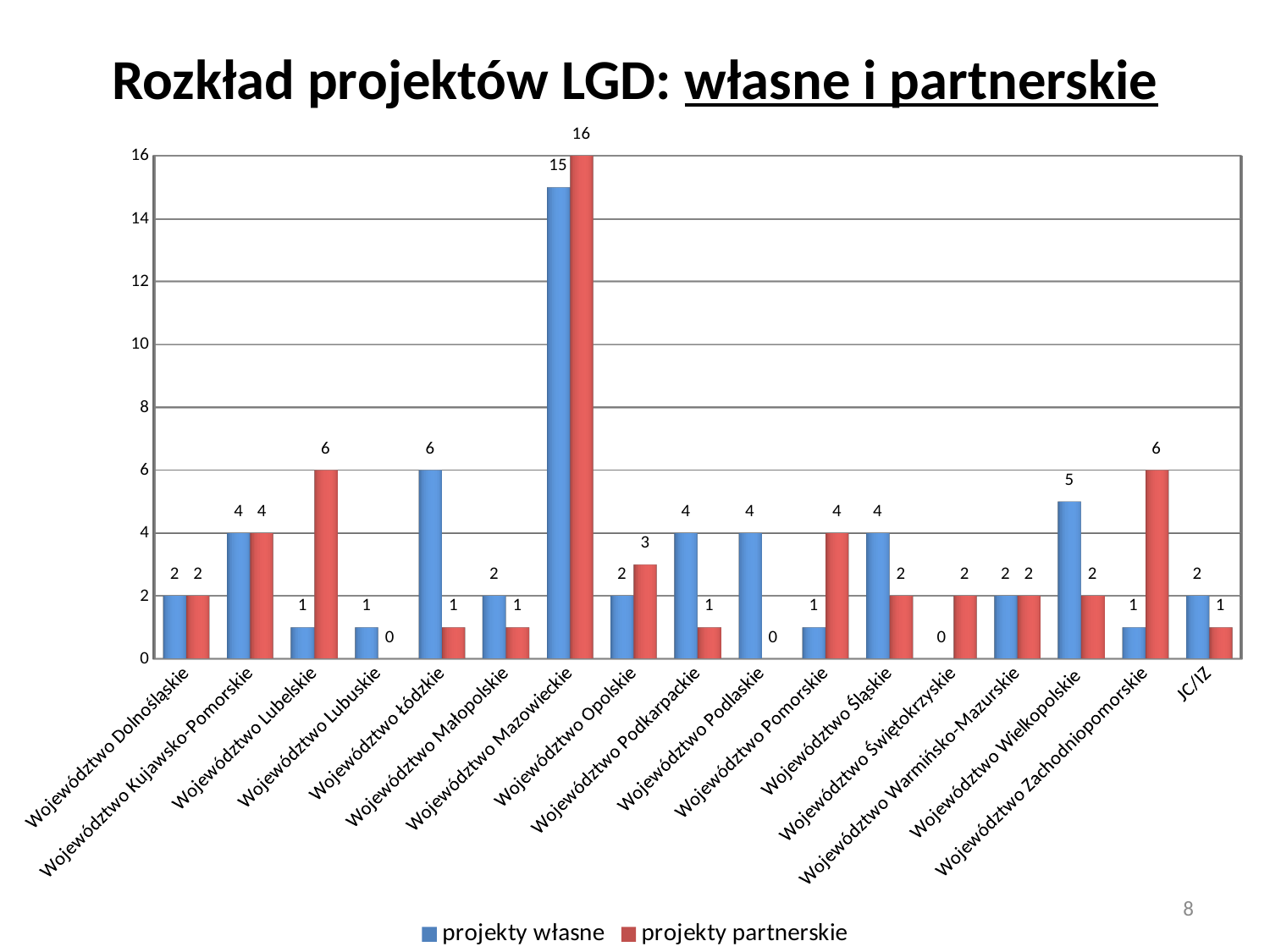
What kind of chart is shown on the slide? bar chart Which colour represents projekty partnerskie in the legend? red Is the value of projekty własne for Województwo Mazowieckie greater or less than 10? greater What is the value of projekty partnerskie for Województwo Zachodniopomorskie? 6 What is the value of projekty własne for Województwo Mazowieckie? 15 What is the value of projekty partnerskie for Województwo Podlaskie? 0 How many series does the legend list? 2 What is the difference between projekty partnerskie and projekty własne for Województwo Lubelskie? 5 Which is larger for Województwo Łódzkie: projekty własne or projekty partnerskie? projekty własne How many categories are shown on the x axis? 17 What is the value of projekty własne for Województwo Wielkopolskie? 5 Which category has the highest value for projekty partnerskie? Województwo Mazowieckie